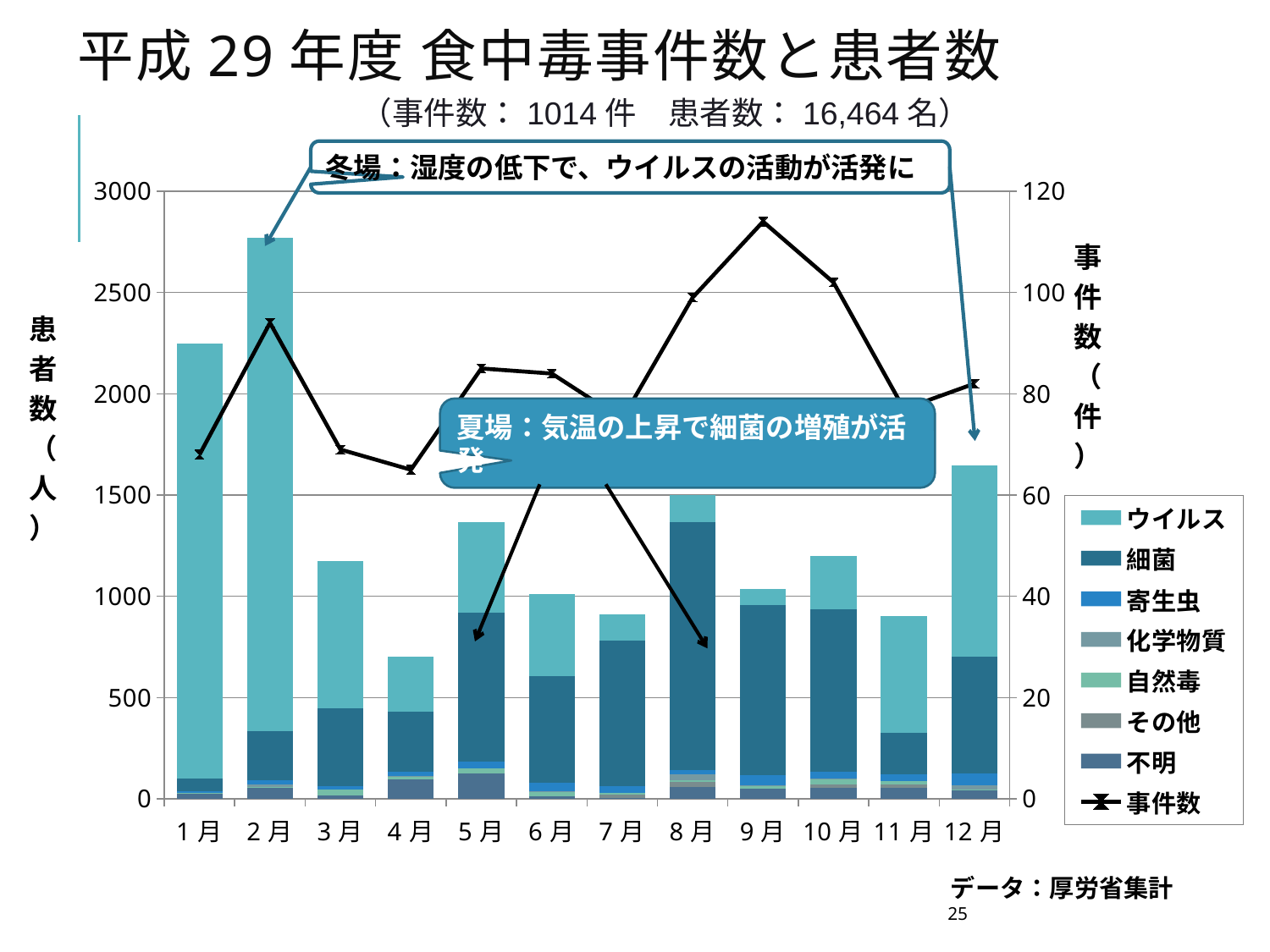
How many months (categories) are shown on the x axis? 12 Which month has the highest number of incidents (事件数 line)? 9月 What is the title of the chart? 平成29年度 食中毒事件数と患者数 What kind of chart is shown on the slide? A combined stacked bar and line chart Which month has the highest total number of patients (tallest stacked bar)? 2月 Does the number of incidents (事件数) rise or fall from 9月 to 11月? fall Is the total number of patients in 4月 greater or less than 1000? less Which month has more total patients, 1月 or 3月? 1月 How many series does the legend list? 8 Which month has the lowest total number of patients (shortest stacked bar)? 4月 Is the total number of patients in 2月 greater or less than 2500? greater Is the number of incidents (事件数) in 9月 greater or less than 100? greater